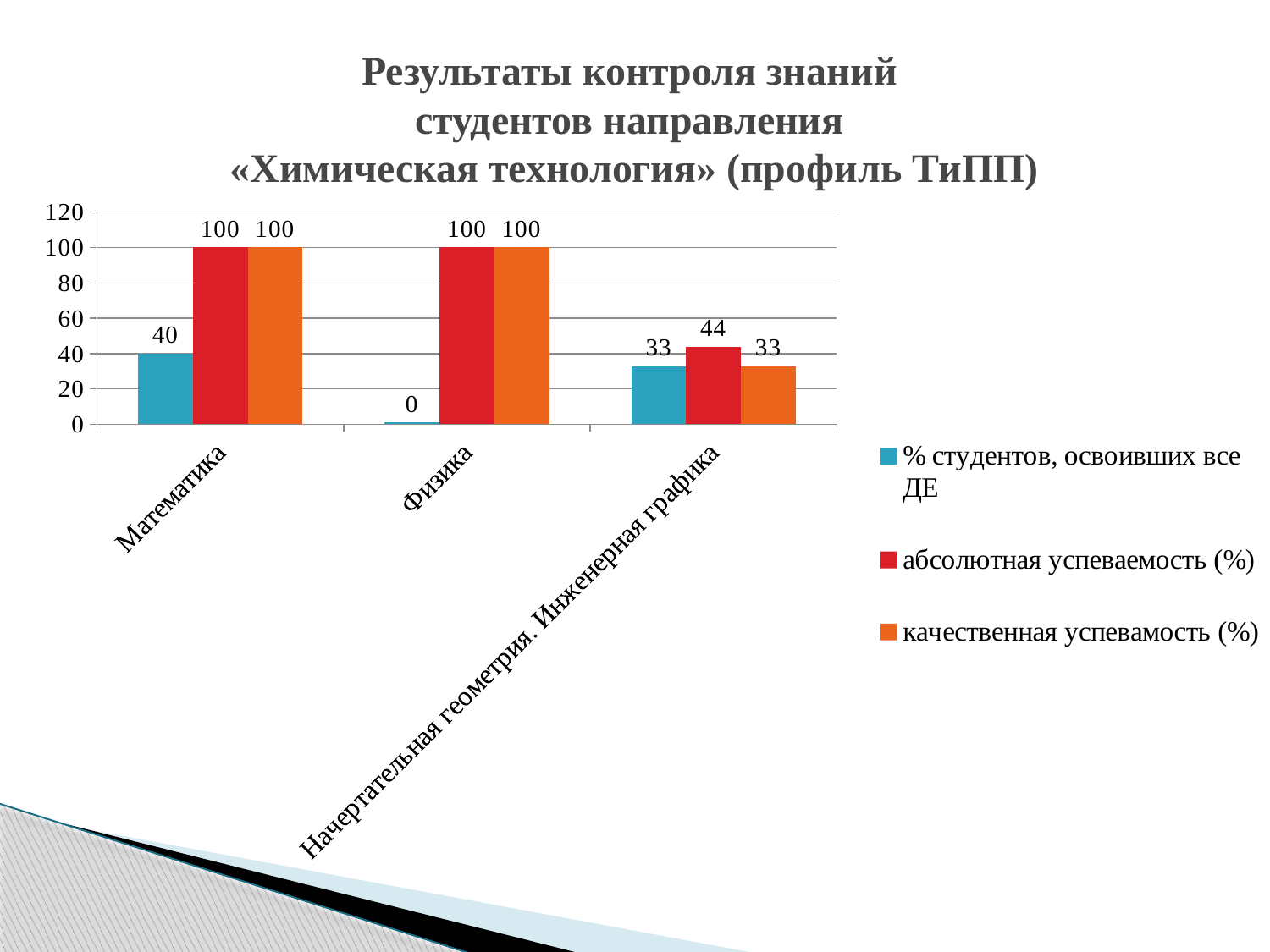
Which is larger: «% студентов, освоивших все ДЕ» for Математика or for Начертательная геометрия. Инженерная графика? Математика What is the value of «качественная успевамость (%)» for Начертательная геометрия. Инженерная графика? 33 How many series does the legend list? 3 How many categories are shown on the x axis? 3 What kind of chart is shown on the slide? Bar chart Which category has the lowest value for «абсолютная успеваемость (%)»? Начертательная геометрия. Инженерная графика What is the value of «% студентов, освоивших все ДЕ» for Математика? 40 What is the value of «абсолютная успеваемость (%)» for Начертательная геометрия. Инженерная графика? 44 Which category has the lowest value for «% студентов, освоивших все ДЕ»? Физика What is the value of «абсолютная успеваемость (%)» for Физика? 100 What is the value of «% студентов, освоивших все ДЕ» for Физика? 0 What is the difference between «абсолютная успеваемость (%)» for Математика and for Начертательная геометрия. Инженерная графика? 56